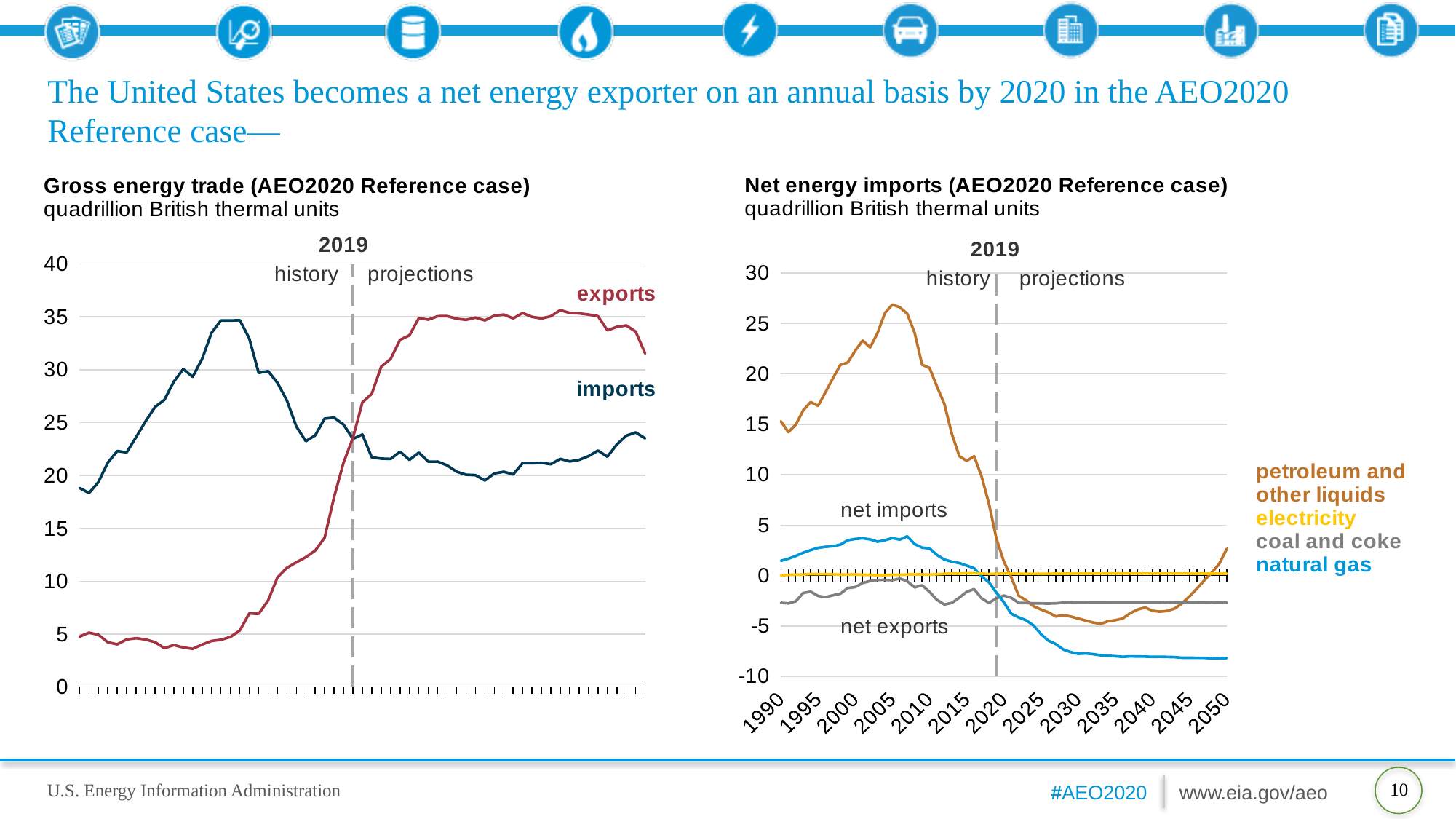
On the 'Gross energy trade' chart, which line is higher at the end of the projection period, exports or imports? exports On the 'Gross energy trade' chart, is the peak value of the imports line greater or less than 30? greater What kind of chart is the 'Gross energy trade (AEO2020 Reference case)' chart? line chart On the 'Net energy imports' chart, which is higher in 2050, coal and coke or natural gas? coal and coke How many series are plotted on the 'Gross energy trade (AEO2020 Reference case)' chart? 2 On the 'Net energy imports' chart, does the petroleum and other liquids line rise or fall between 2005 and 2020? fall On the 'Net energy imports' chart, which series has the highest value in 2005? petroleum and other liquids How many series does the legend of the 'Net energy imports (AEO2020 Reference case)' chart list? 4 On the 'Net energy imports' chart, is the value for natural gas in 2050 greater or less than -5? less On the 'Net energy imports' chart, is the value for petroleum and other liquids in 2005 greater or less than 25? greater Which year separates history from projections on both charts? 2019 On the 'Net energy imports' chart, does the natural gas line rise or fall between 2020 and 2050? fall